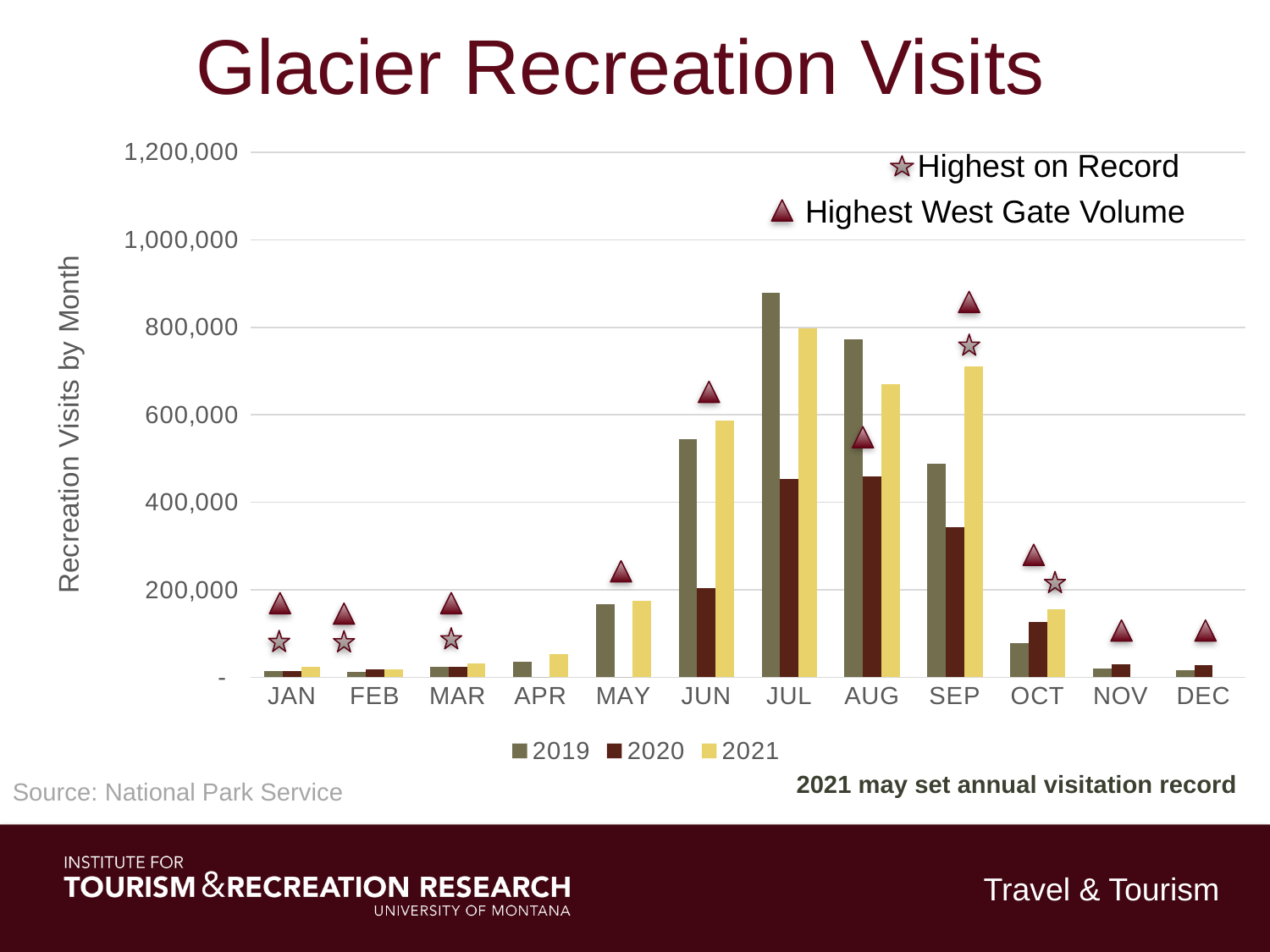
Is the 2021 value for JUN greater or less than 400,000? greater What is the title of the y axis? Recreation Visits by Month How many months are shown on the x axis? 12 Is the 2020 value for SEP greater or less than 400,000? less How many series does the legend list? 3 Which month has the highest 2019 value? JUL Which series has the lowest value in JUL? 2020 Is the 2019 value for JUL greater or less than 800,000? greater In SEP, which is larger: the 2019 value or the 2021 value? 2021 Which month has the highest 2021 value? JUL What kind of chart is shown on the slide? bar chart